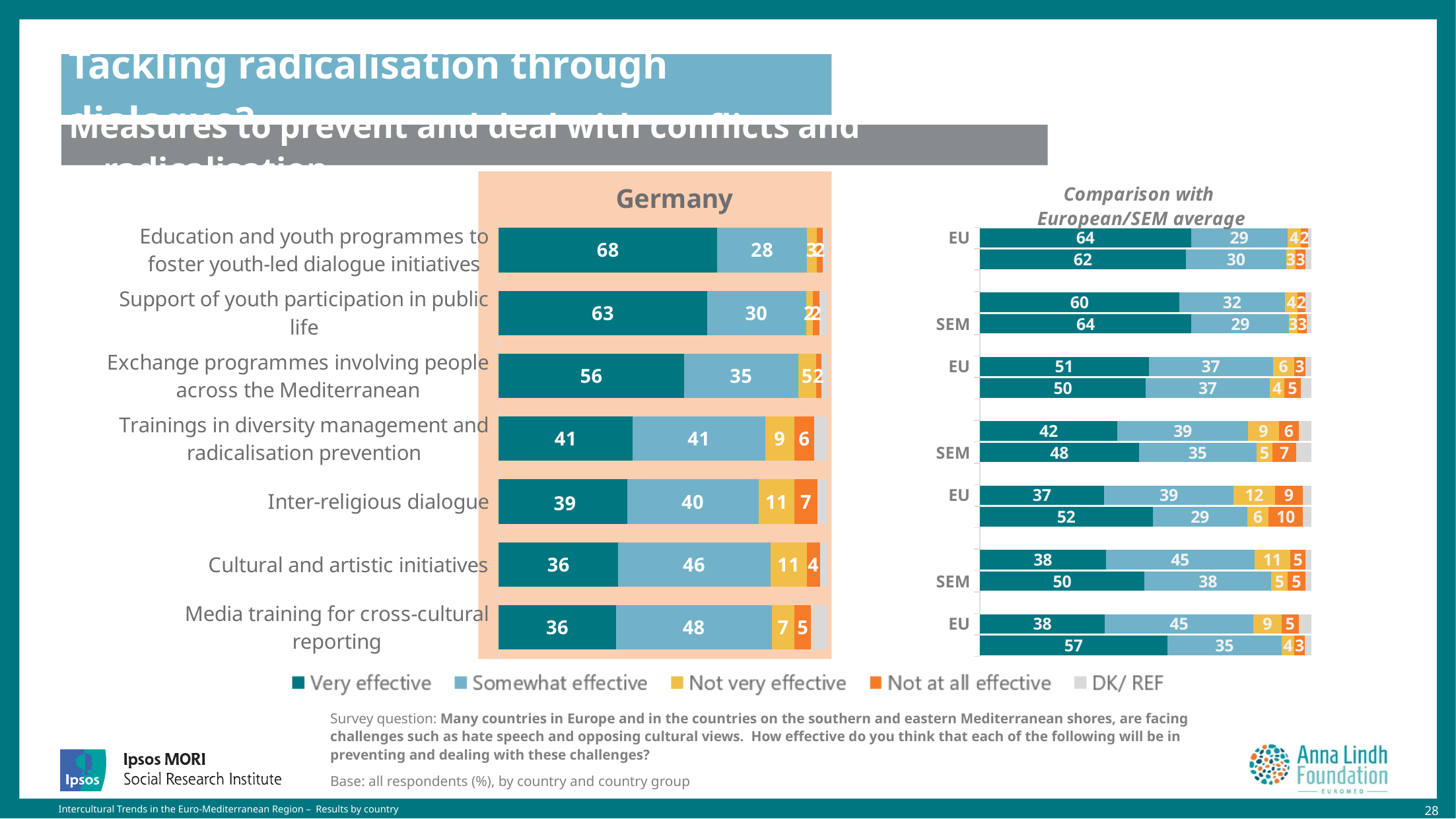
What kind of chart is the Germany chart? Stacked bar chart In the Germany chart, what percentage rated 'Education and youth programmes to foster youth-led dialogue initiatives' as very effective? 68 In the Germany chart, what is the difference between the 'Very effective' values for 'Support of youth participation in public life' and 'Exchange programmes involving people across the Mediterranean'? 7 How many series does the legend list? 5 In the Germany chart, which measure has the lowest 'Somewhat effective' value? Education and youth programmes to foster youth-led dialogue initiatives In the Germany chart, which measure has the highest 'Very effective' value? Education and youth programmes to foster youth-led dialogue initiatives In the Germany chart, what is the 'Somewhat effective' value for 'Media training for cross-cultural reporting'? 48 How many measures are listed in the Germany chart? 7 In the 'Comparison with European/SEM average' chart, what is the SEM 'Very effective' value for the last measure (Media training for cross-cultural reporting)? 57 In the Germany chart, is the 'Very effective' value larger for 'Trainings in diversity management and radicalisation prevention' or for 'Inter-religious dialogue'? Trainings in diversity management and radicalisation prevention In the 'Comparison with European/SEM average' chart, what is the EU 'Not very effective' value for 'Inter-religious dialogue' (the fifth pair of bars)? 12 In the Germany chart, what is the 'Not very effective' value for 'Inter-religious dialogue'? 11